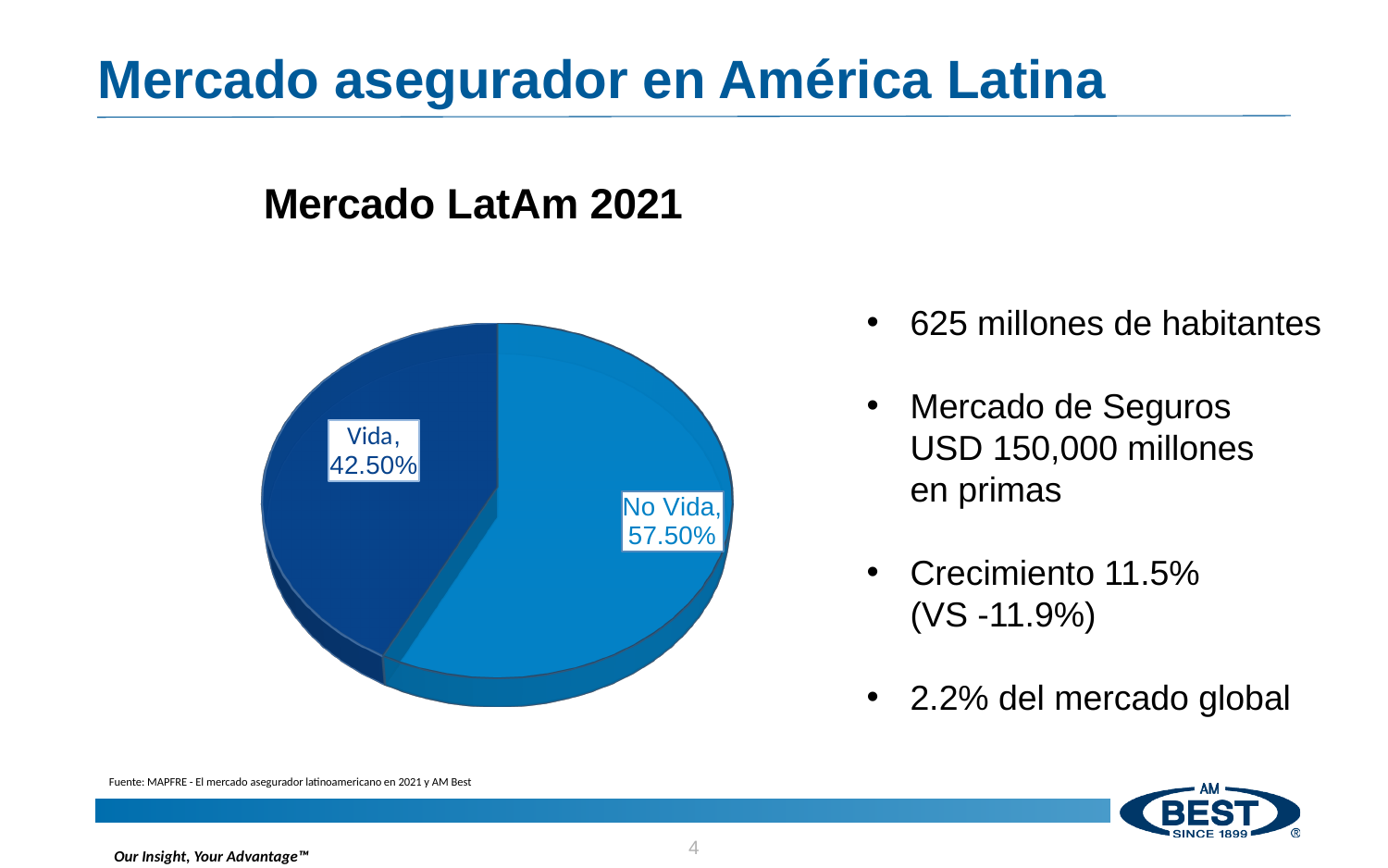
What is the title of the chart? Mercado LatAm 2021 What kind of chart is shown on the slide? Pie chart How many slices does the pie chart have? 2 Is the share for Vida greater or less than 50%? less Which is larger, the Vida slice or the No Vida slice? No Vida Is the share for No Vida greater or less than 50%? greater Which slice is the smallest in the pie chart? Vida What share of the pie does the No Vida slice represent? 57.50% Which slice is the largest in the pie chart? No Vida What is the total of the two slices shown in the pie chart? 100% What share of the pie does the Vida slice represent? 42.50% What is the difference in percentage points between the No Vida and Vida slices? 15 percentage points